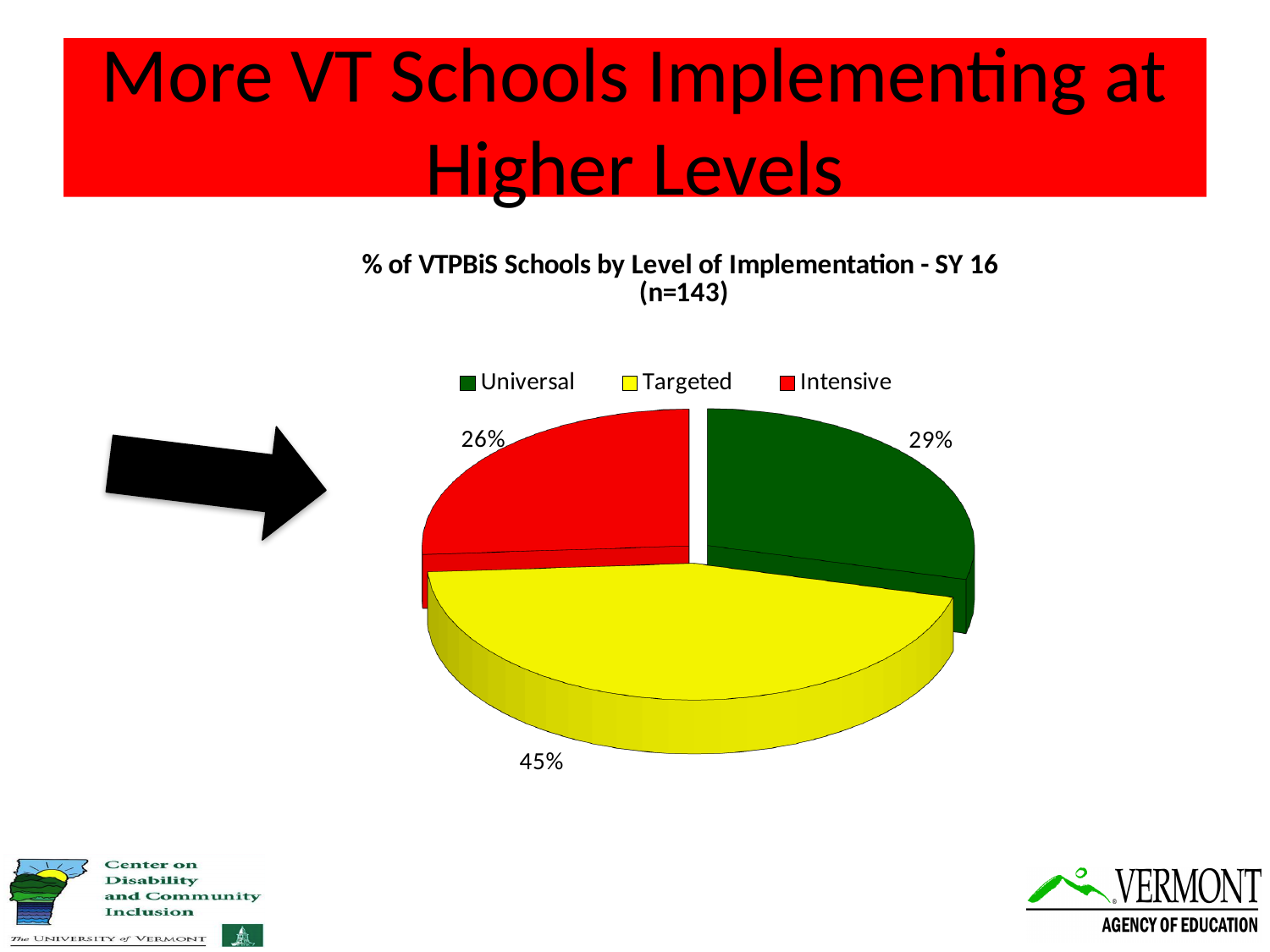
What percentage of VTPBiS schools are at the Universal level of implementation? 29% Which level of implementation has the largest share of schools? Targeted What colour represents the Targeted level in the pie chart? Yellow How many slices does the pie chart have? 3 How many schools are included in the chart (n)? 143 What percentage of VTPBiS schools are at the Targeted level of implementation? 45% What percentage of VTPBiS schools are at the Intensive level of implementation? 26% What is the difference in percentage points between the Targeted and Universal shares? 16 Which level of implementation has the smallest share of schools? Intensive Which is larger, the Universal share or the Intensive share? Universal What is the difference in percentage points between the Universal and Intensive shares? 3 What kind of chart is shown on the slide? Pie chart